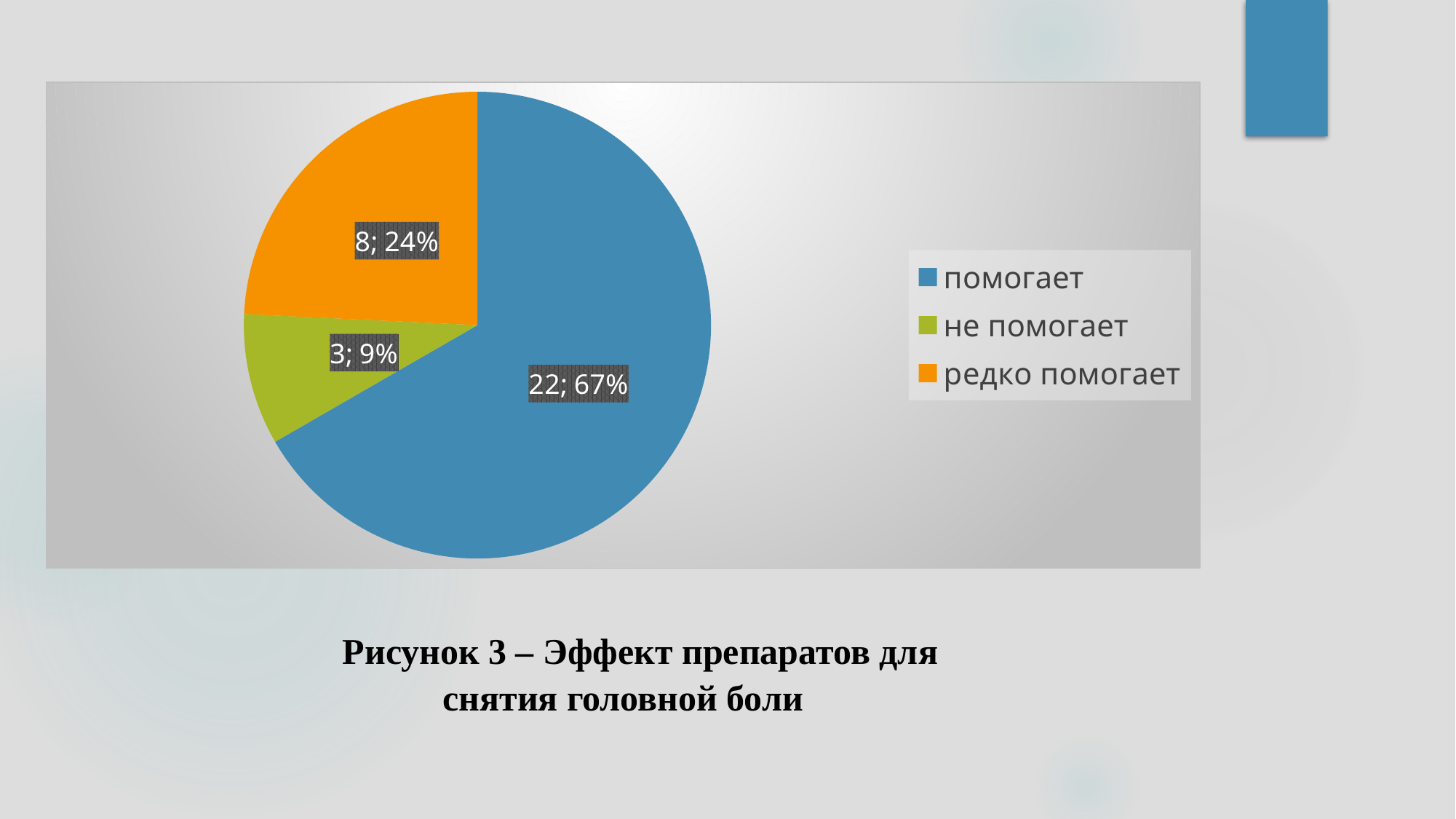
What is the count shown for the 'помогает' slice? 22 How many entries does the legend list? 3 Which category has the smallest slice? не помогает What percentage share does the 'помогает' slice have? 67% What is the count shown for the 'не помогает' slice? 3 What kind of chart is shown on the slide? pie chart What is the difference in count between 'помогает' and 'редко помогает'? 14 Which is larger, the 'не помогает' slice or the 'редко помогает' slice? редко помогает What percentage share does the 'редко помогает' slice have? 24% Which category has the largest slice? помогает How many slices does the pie chart have? 3 What colour is the 'редко помогает' slice? orange